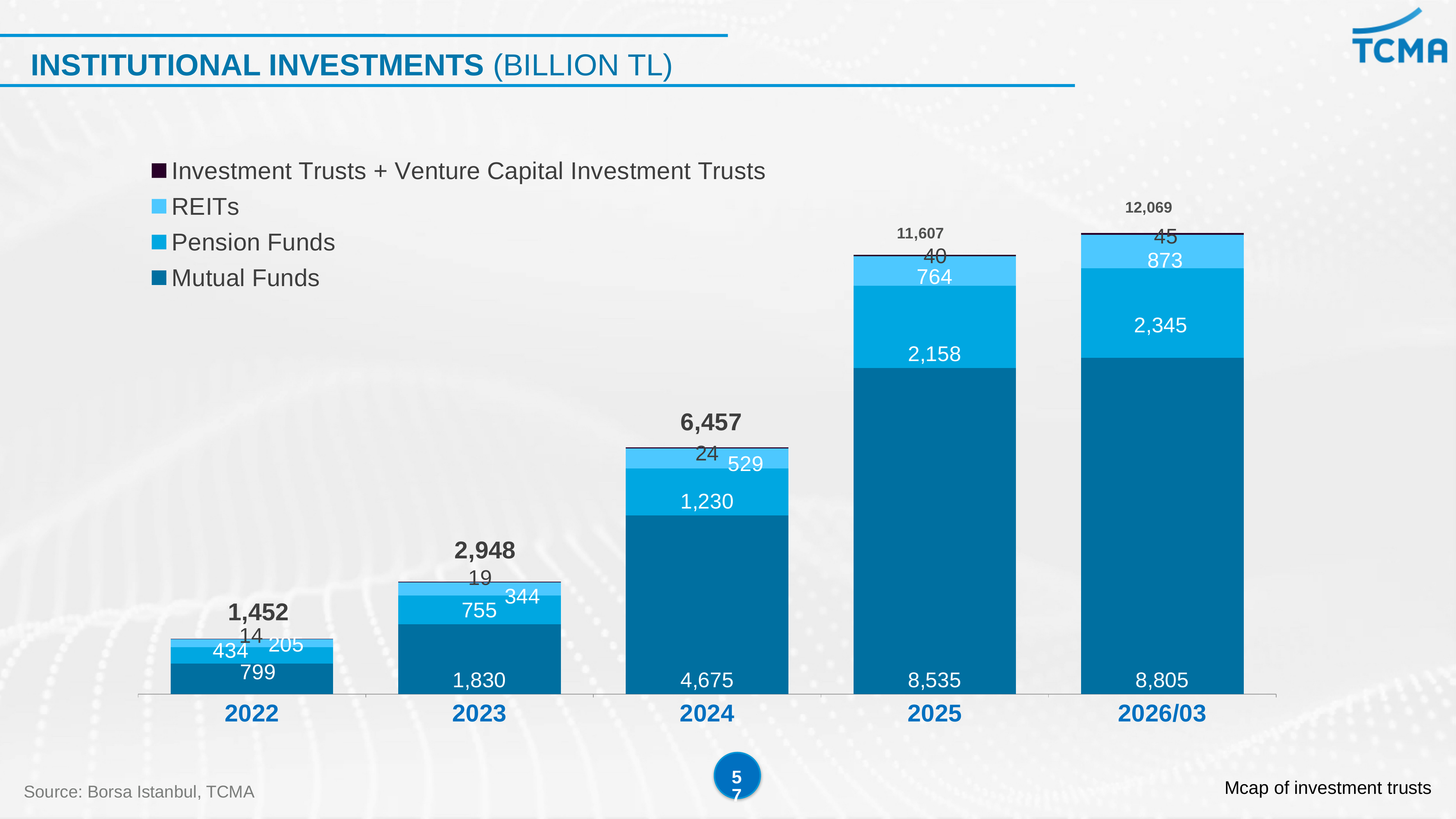
How many series does the legend list? 4 Which year has the highest total institutional investments? 2026/03 What is the value for Investment Trusts + Venture Capital Investment Trusts in 2022? 14 How many years are shown on the x axis? 5 What is the total of the stacked bar for 2023? 2,948 Which is larger, the Pension Funds value in 2024 or the REITs value in 2026/03? Pension Funds in 2024 What is the value for Pension Funds in 2025? 2,158 What is the value for REITs in 2026/03? 873 What kind of chart is shown on the slide? Stacked bar chart What is the value for Mutual Funds in 2024? 4,675 Which year has the lowest value for Mutual Funds? 2022 What is the difference between the Mutual Funds values for 2026/03 and 2025? 270